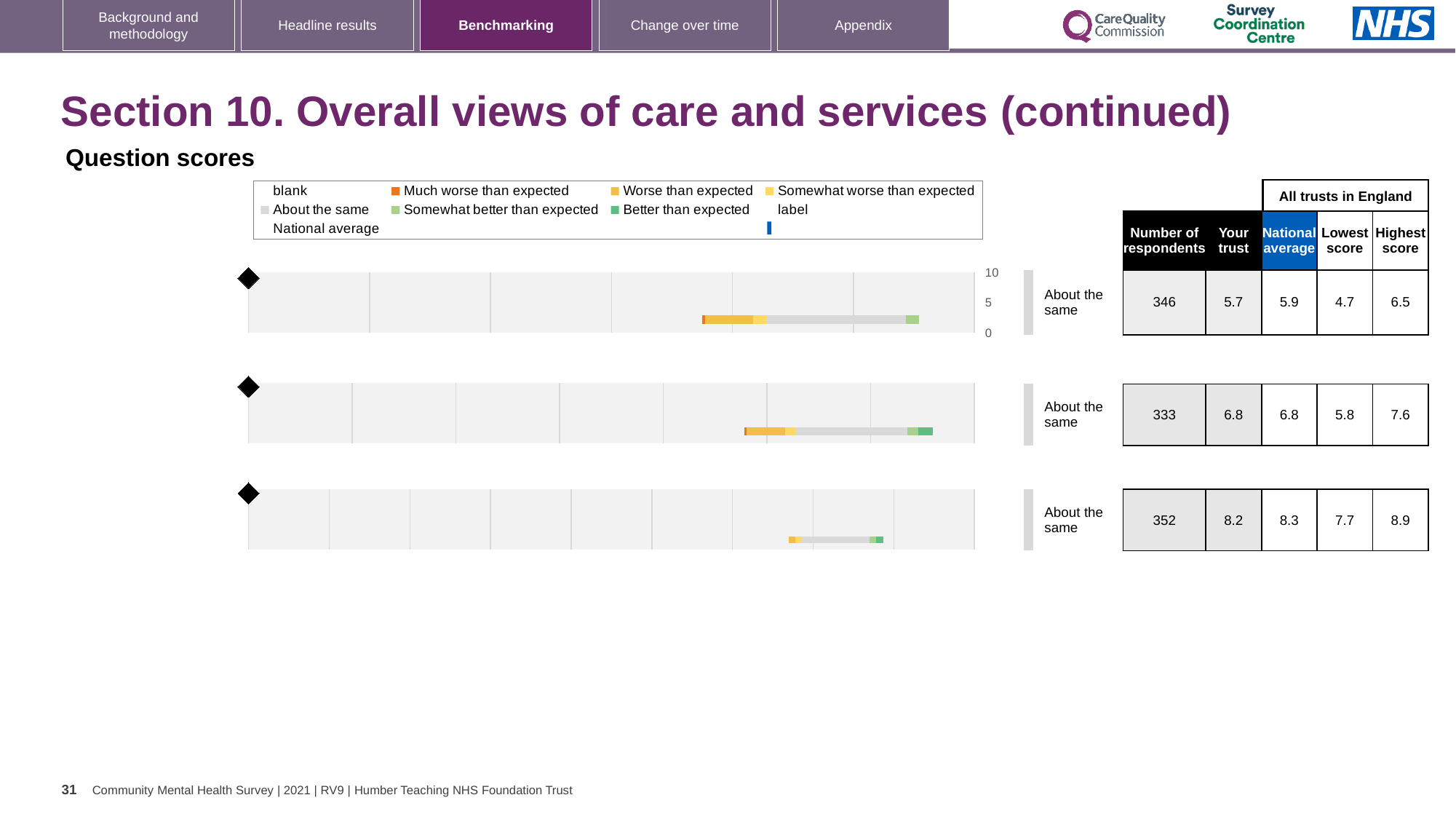
Which legend entry is shown in orange? Much worse than expected For the middle chart, what benchmark category is the trust's score placed in? About the same For the bottom chart, what is the highest score among all trusts in England? 8.9 What kind of chart is used on this slide? bar chart Which chart has the highest 'Your trust' score? the bottom chart How many entries does the legend list? 9 For the top chart, what is the difference between the highest score and the lowest score? 1.8 For the bottom chart, which is larger: the 'Your trust' score or the national average? National average For the top chart, what is the 'Your trust' score? 5.7 For the top chart, how many respondents are there? 346 How many benchmarking charts are shown on the slide? 3 For the middle chart, what is the national average score? 6.8